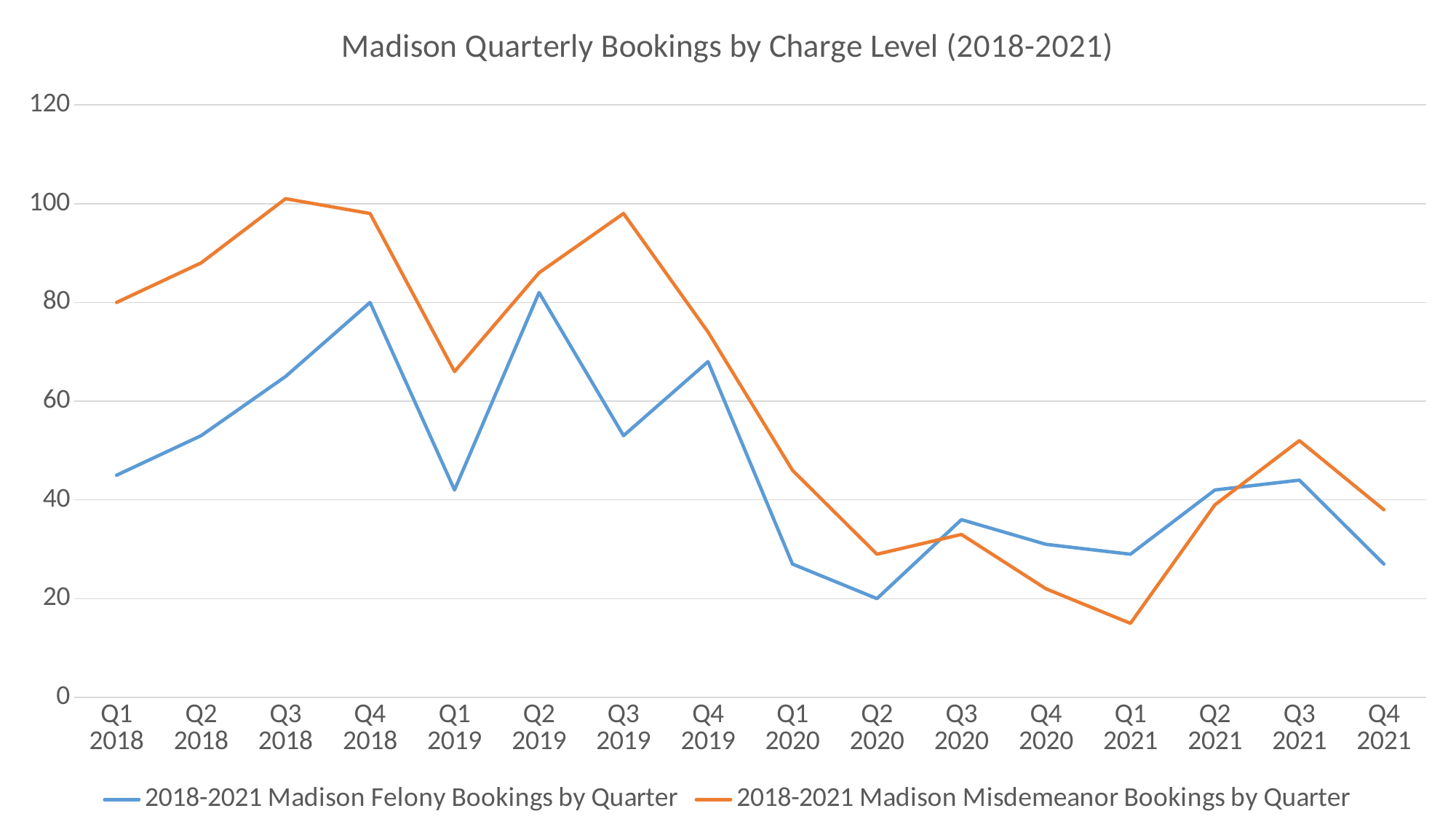
Is the Misdemeanor Bookings value for Q3 2021 greater or less than 40? greater In Q3 2019, which series has the higher value, Felony Bookings or Misdemeanor Bookings? Misdemeanor Bookings Is the Felony Bookings value for Q4 2021 greater or less than 40? less In which quarter is the Felony Bookings series at its lowest? Q2 2020 Is the Felony Bookings value for Q1 2018 greater or less than 40? greater Does the Misdemeanor Bookings series rise or fall from Q1 2018 to Q3 2018? rise In Q1 2021, which series has the higher value, Felony Bookings or Misdemeanor Bookings? Felony Bookings How many quarters are plotted along the x axis? 16 What kind of chart is shown on the slide? line chart How many series does the legend list? 2 In which quarter is the Misdemeanor Bookings series at its lowest? Q1 2021